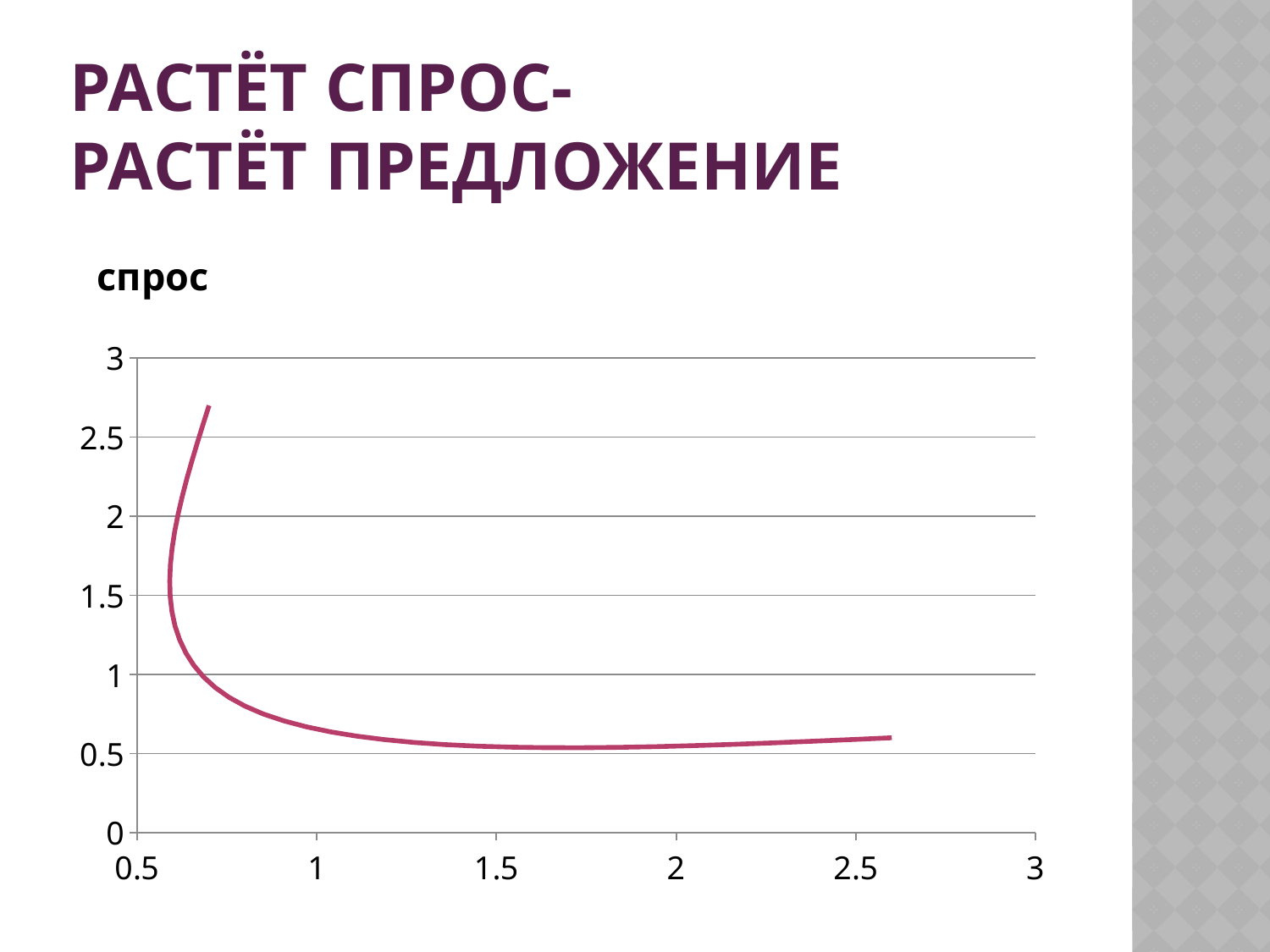
Which is larger: the value of the curve at x = 1 or at x = 2? at x = 1 How many curves are plotted on the chart? 1 What kind of chart is shown on the slide? line chart Is the value of the curve at x = 2.5 greater or less than 1? less What is the title of the chart? спрос Is the lowest point of the curve greater or less than 1? less Is the value of the curve at x = 1.5 greater or less than 1? less Does the curve rise or fall as x increases from 1 to 1.5? falls What is the highest value shown on the vertical axis of the chart? 3